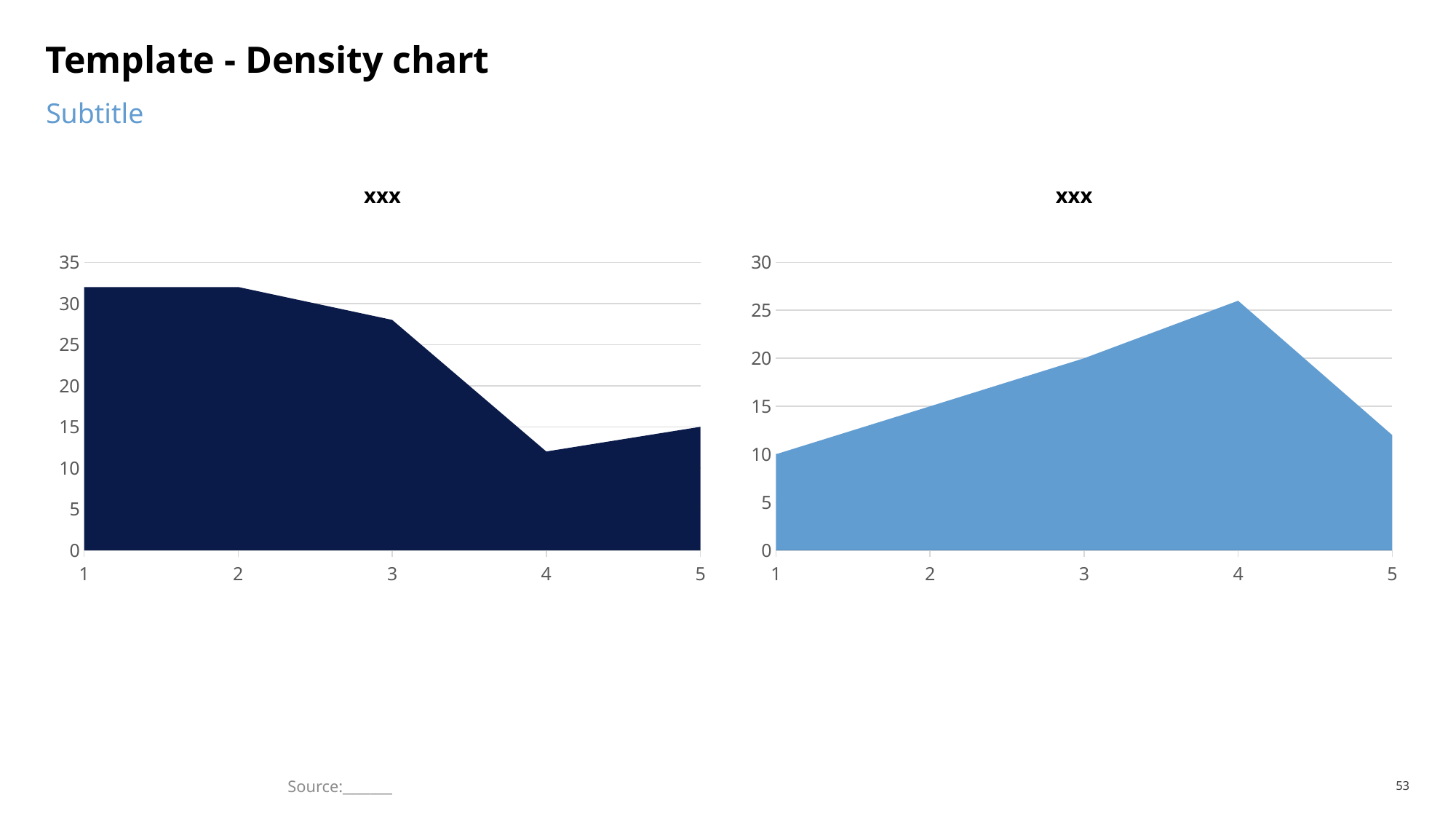
What kind of chart is the left chart? area chart In the right chart, do the values rise or fall from x = 1 to x = 4? rise In the right chart, which x-axis category has the highest value? 4 In the right chart, is the value at x = 4 greater or less than 25? greater What is the title shown above the right chart? xxx In the right chart, is the value at x = 5 greater or less than 15? less How many points are plotted along the x axis of the right chart? 5 In the left chart, which x-axis category has the lowest value? 4 In the left chart, is the value at x = 4 greater or less than 15? less In the left chart, which is larger, the value at x = 3 or the value at x = 4? 3 In the right chart, what is the value at x = 1? 10